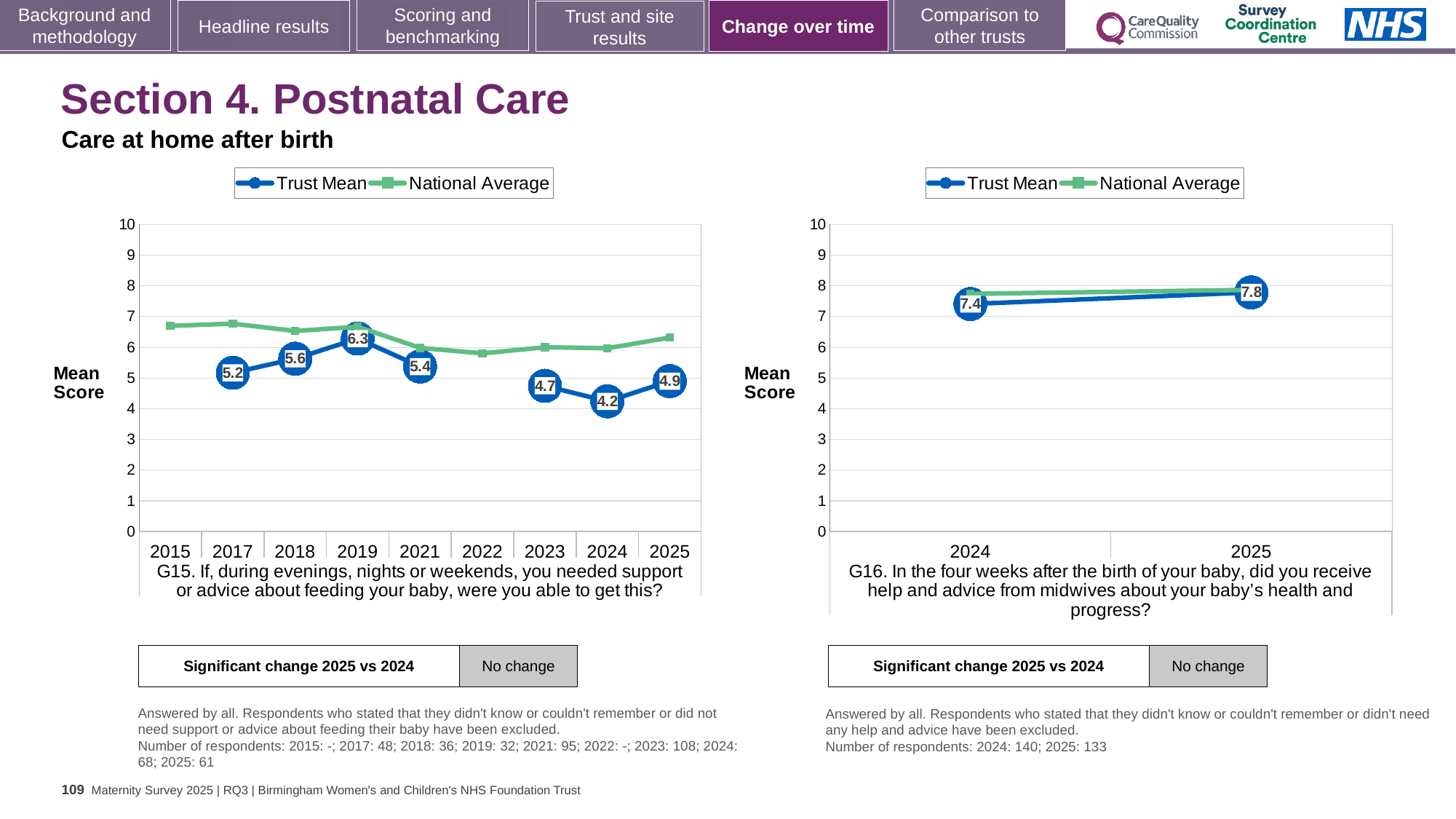
In the G16 chart on the right, what is the Trust Mean for 2025? 7.8 In the G15 chart on the left, is the Trust Mean for 2018 greater or less than the National Average for 2018? less In the G16 chart on the right, what is the difference between the Trust Mean in 2025 and in 2024? 0.4 What type of chart is the G16 chart on the right? line chart In the G15 chart on the left, is the National Average for 2015 greater or less than 6? greater In the G15 chart on the left, what is the Trust Mean for 2024? 4.2 In the G15 chart on the left, which year has the lowest Trust Mean? 2024 In the G16 chart on the right, does the Trust Mean rise or fall from 2024 to 2025? rise In the G15 chart on the left, which year has the highest Trust Mean? 2019 In the G15 chart on the left, what is the difference between the Trust Mean in 2025 and in 2024? 0.7 In the G15 chart on the left, what is the Trust Mean for 2019? 6.3 In the G15 chart on the left, how many years are shown on the x axis? 9